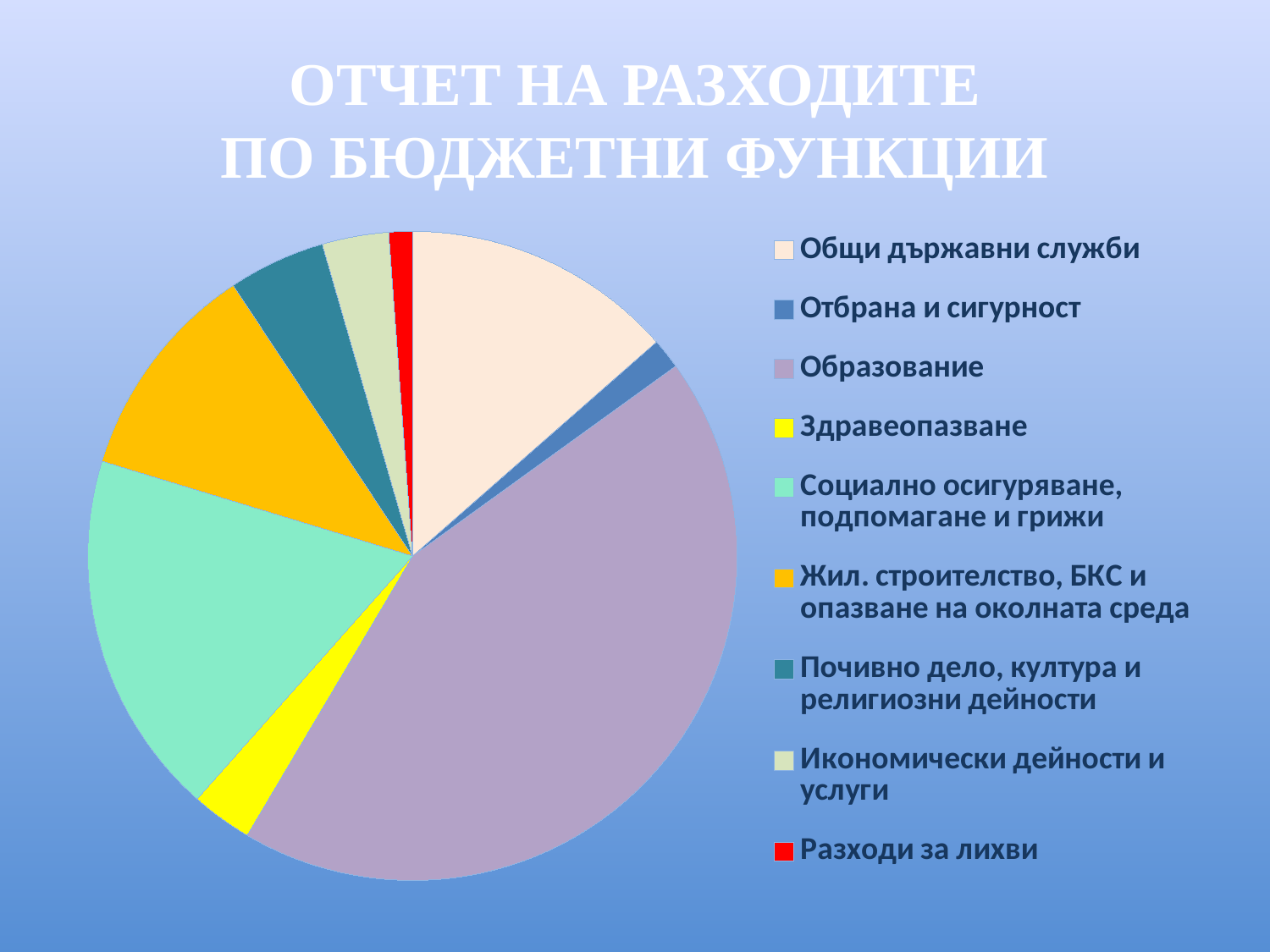
Which is larger: the slice for Социално осигуряване, подпомагане и грижи or the slice for Здравеопазване? Социално осигуряване, подпомагане и грижи How many categories (slices) does the pie chart have? 9 Which is larger: the slice for Образование or the slice for Общи държавни служби? Образование What colour is the slice for Разходи за лихви? red Which is larger: the slice for Жил. строителство, БКС и опазване на околната среда or the slice for Почивно дело, култура и религиозни дейности? Жил. строителство, БКС и опазване на околната среда What is the title of the slide containing the pie chart? ОТЧЕТ НА РАЗХОДИТЕ ПО БЮДЖЕТНИ ФУНКЦИИ How many entries does the legend list? 9 Which category has the largest slice of the pie? Образование What kind of chart is shown on the slide? pie chart